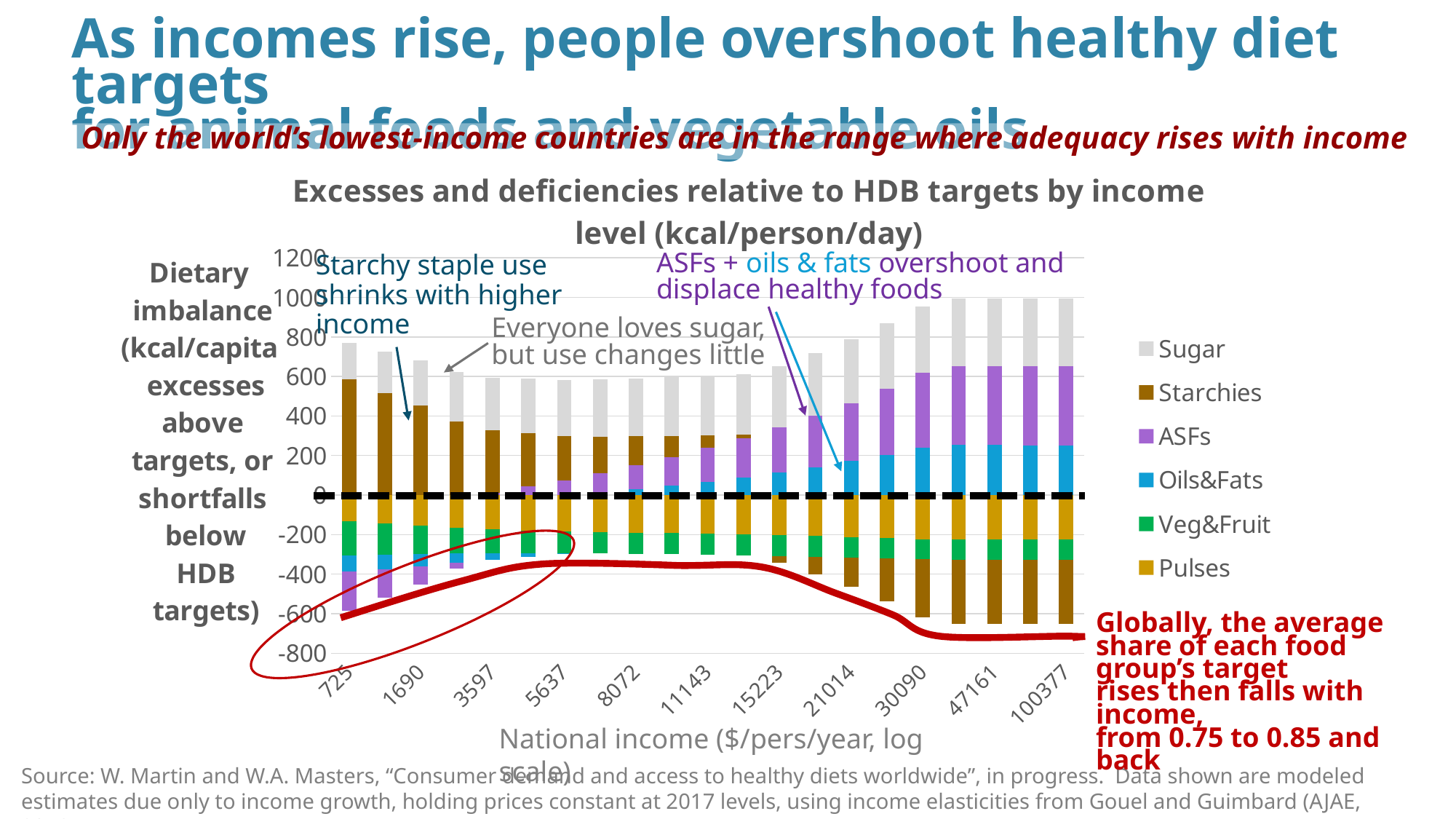
Is the top of the positive (above-zero) stack for the 100377 income level greater or less than 800? greater What is the title of the chart? Excesses and deficiencies relative to HDB targets by income level (kcal/person/day) Is the top of the positive (above-zero) stack for the 725 income level greater or less than 600? greater What kind of chart is shown on the slide? Stacked bar chart What is the x-axis title of the chart? National income ($/pers/year, log scale) Does the Starchies excess above zero rise or fall as national income increases along the x axis? Fall How many series does the chart legend list? 6 Is the top of the positive stack at the 5637 income level greater or less than 800? less Which income level has a taller positive (above-zero) stack, 725 or 100377? 100377 Does the ASFs excess above zero rise or fall as national income increases from 15223 to 100377? Rise Which series is shown in purple in the chart? ASFs